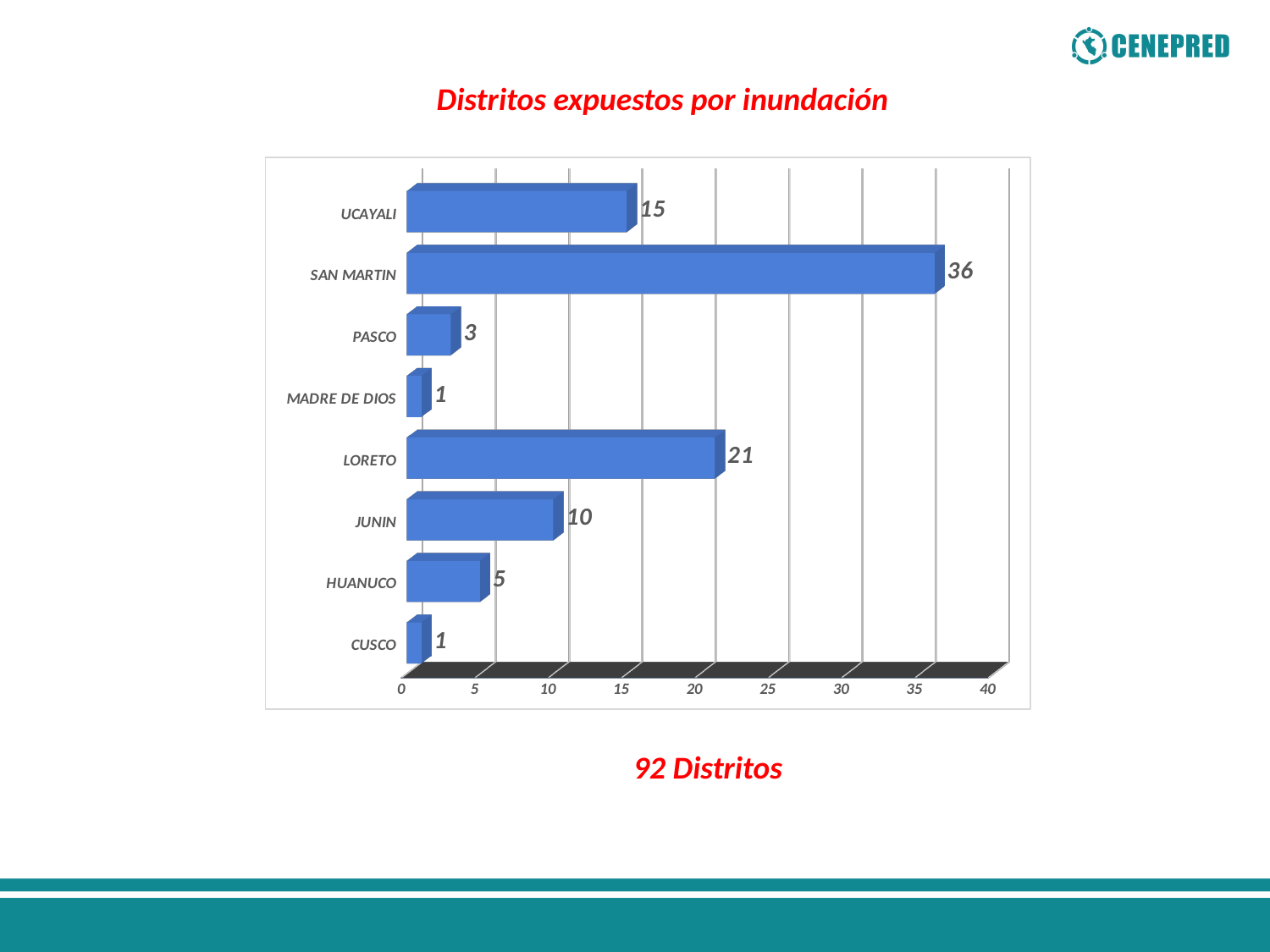
What is the difference between the values for SAN MARTIN and LORETO? 15 Which category has the lowest value? MADRE DE DIOS and CUSCO Which category has the highest value? SAN MARTIN Which is larger, the value for UCAYALI or the value for JUNIN? UCAYALI What is the value for HUANUCO? 5 Is the value for LORETO greater or less than 20? greater How many categories are shown in the chart? 8 What is the value for LORETO? 21 What total number of districts is stated below the chart? 92 Distritos What is the value for SAN MARTIN? 36 What kind of chart is shown on the slide? bar chart What is the title of the chart? Distritos expuestos por inundación